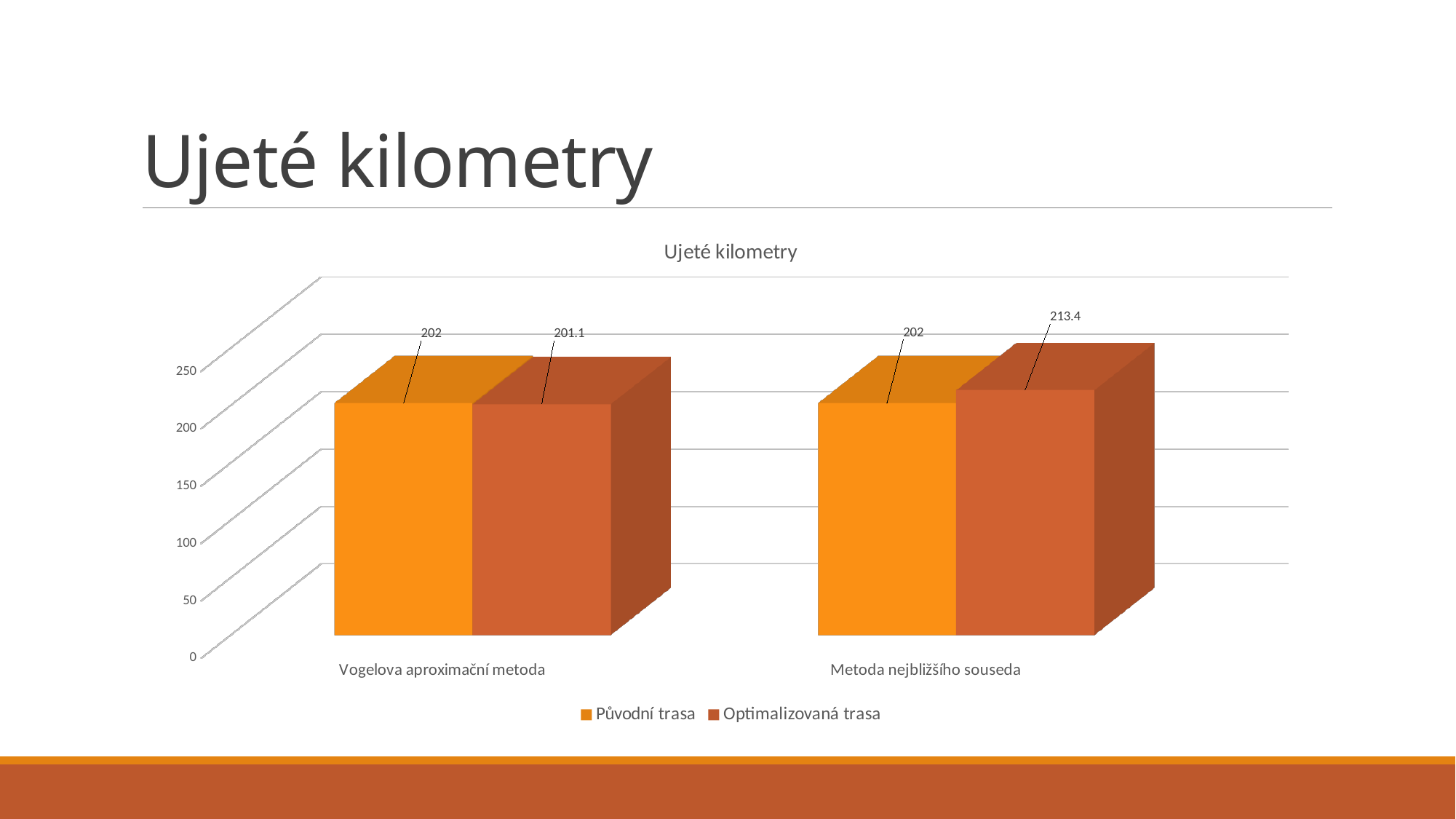
How many categories are shown on the x axis? 2 What is the value of Původní trasa for Vogelova aproximační metoda? 202 How many series does the legend list? 2 Which is larger for Metoda nejbližšího souseda: Původní trasa or Optimalizovaná trasa? Optimalizovaná trasa What is the difference between Původní trasa and Optimalizovaná trasa for Metoda nejbližšího souseda? 11.4 What is the value of Optimalizovaná trasa for Metoda nejbližšího souseda? 213.4 What is the value of Původní trasa for Metoda nejbližšího souseda? 202 What is the difference between the Optimalizovaná trasa values for Metoda nejbližšího souseda and Vogelova aproximační metoda? 12.3 What is the title of the chart? Ujeté kilometry Which category has the highest Optimalizovaná trasa value? Metoda nejbližšího souseda What kind of chart is shown on the slide? Bar chart What is the value of Optimalizovaná trasa for Vogelova aproximační metoda? 201.1